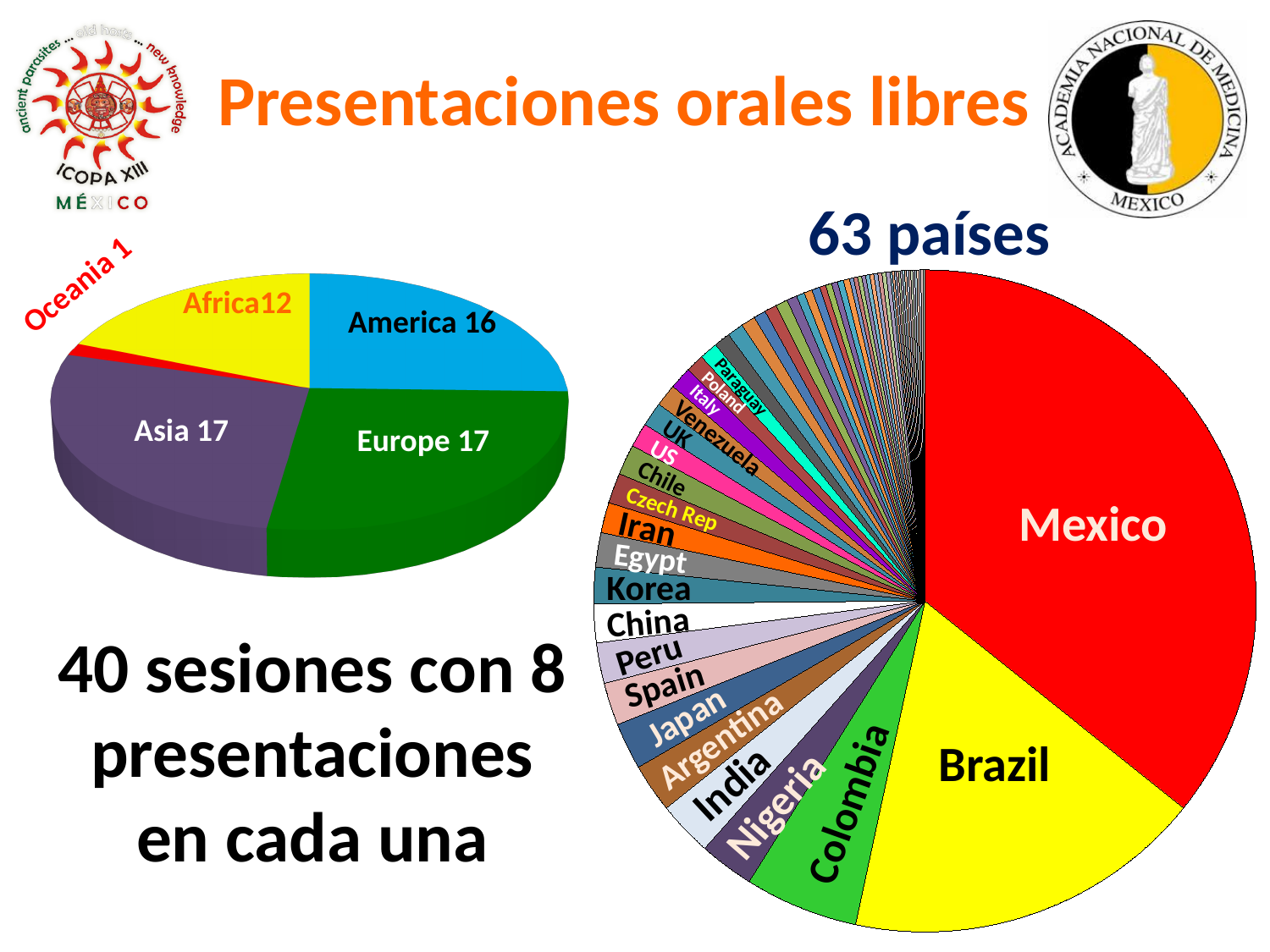
In the left pie chart, what is the value for Asia? 17 In the left pie chart, what is the total of all the region values? 63 In the left pie chart, which is larger, America or Africa? America In the left pie chart, what is the value for Africa? 12 In the left pie chart, which region has the lowest value? Oceania In the '63 países' pie chart, which country has the largest slice? Mexico In the left pie chart, how many regions are shown? 5 In the left pie chart, what is the value for America? 16 In the left pie chart, what is the difference between Europe and Africa? 5 In the '63 países' pie chart, which slice is larger, Brazil or Colombia? Brazil What is the title of the pie chart on the right? 63 países What kind of chart is the chart on the left? Pie chart